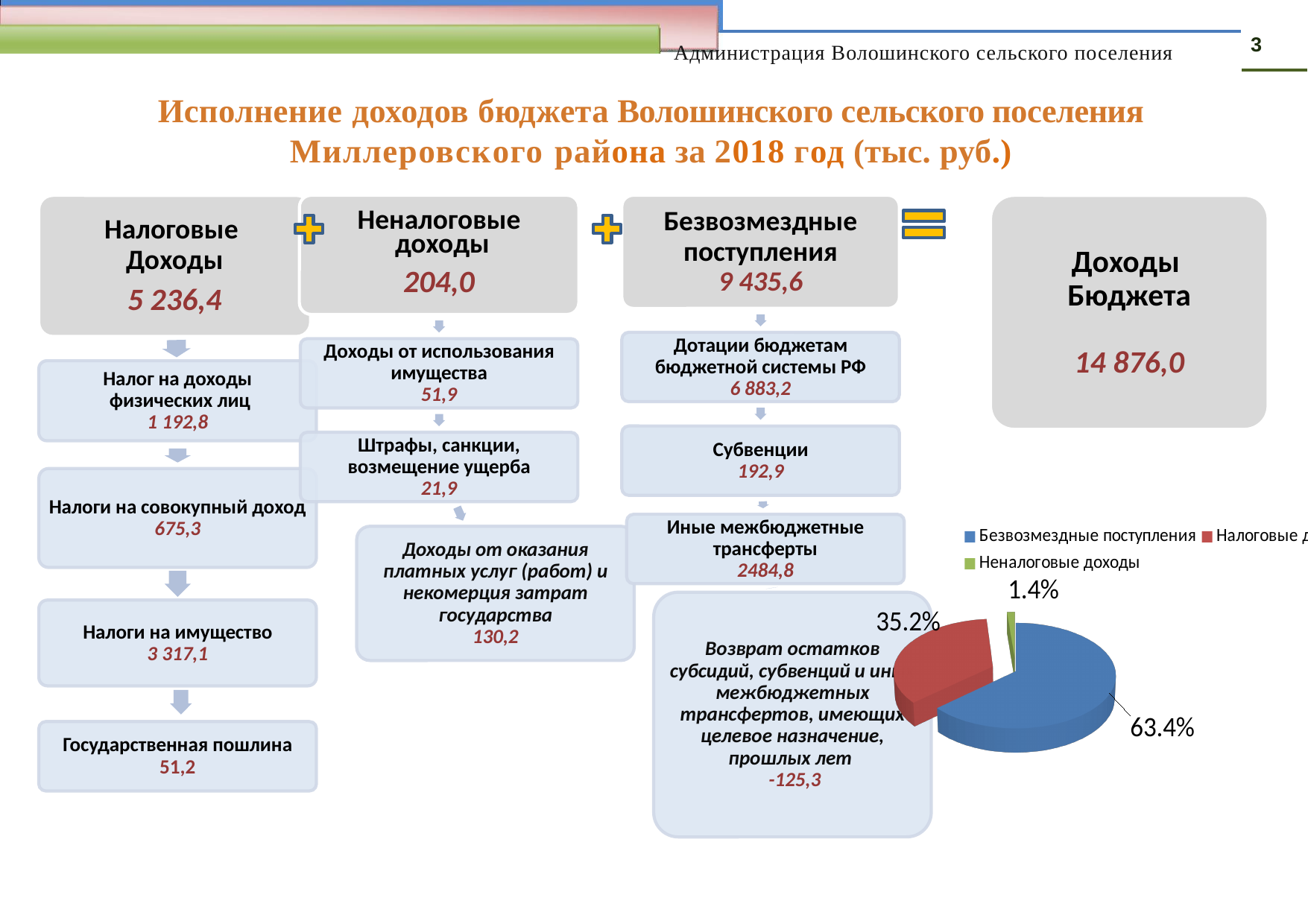
What colour is the Неналоговые доходы slice in the pie chart? green How many slices does the pie chart have? 3 What is the difference in percentage points between the Безвозмездные поступления slice and the Неналоговые доходы slice? 62.0% How many entries does the pie chart legend list? 3 What share of the pie does the red slice represent? 35.2% Which slice of the pie chart is the largest? Безвозмездные поступления Is the share for Безвозмездные поступления greater or less than 50%? greater What share of the pie does Безвозмездные поступления represent? 63.4% What kind of chart is shown on the slide? pie chart What share of the pie does Неналоговые доходы represent? 1.4% Which slice of the pie chart is the smallest? Неналоговые доходы Which is larger in the pie chart: Безвозмездные поступления or Неналоговые доходы? Безвозмездные поступления